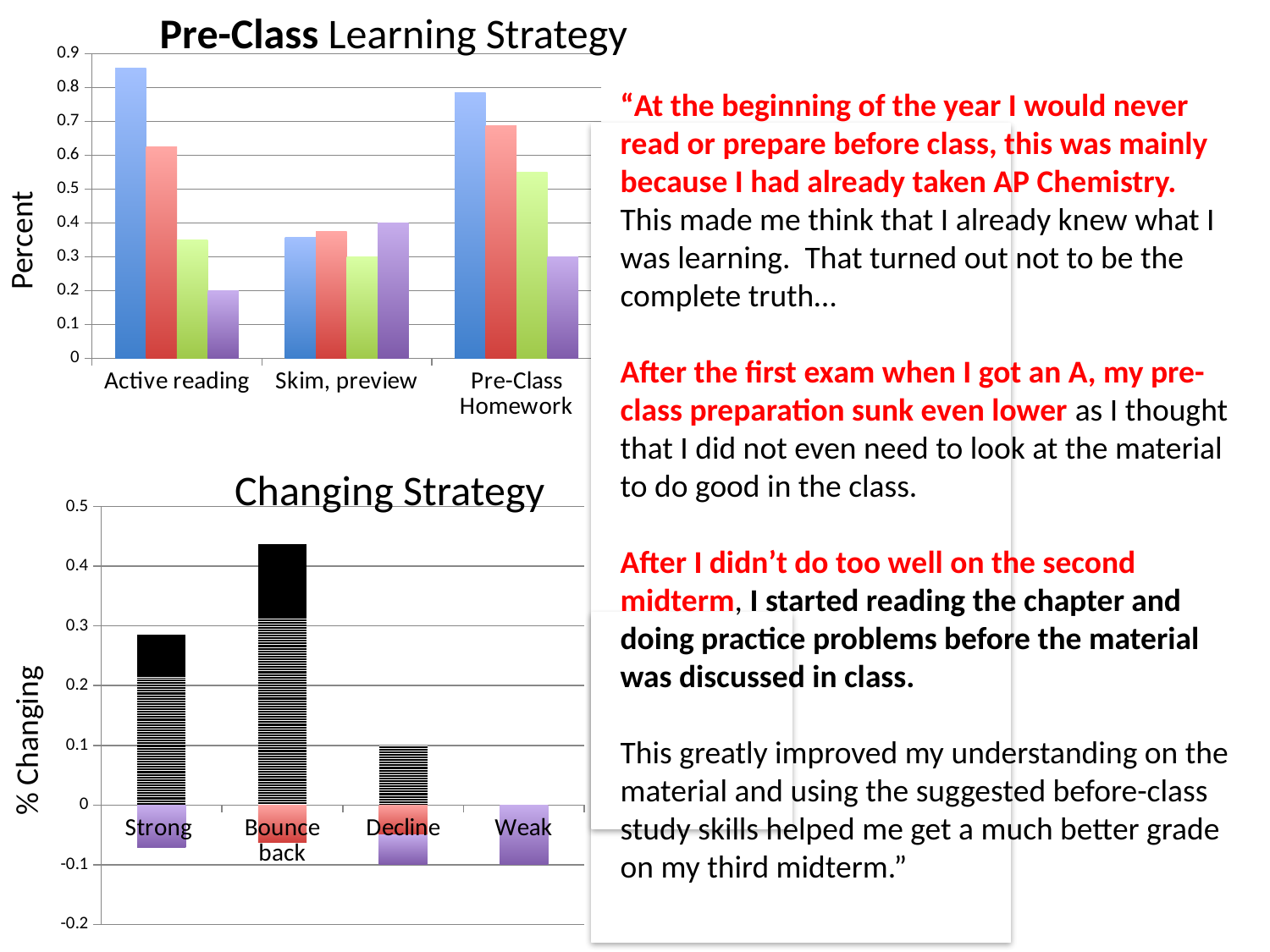
In the 'Pre-Class Learning Strategy' chart, is the blue bar for Active reading greater or less than 0.8? greater In the 'Pre-Class Learning Strategy' chart, is the green bar for Pre-Class Homework greater or less than 0.5? greater In the 'Changing Strategy' chart, which category has the tallest stacked bar above zero? Bounce back What is the y-axis label of the 'Pre-Class Learning Strategy' chart? Percent In the 'Changing Strategy' chart, is the top of the stacked bar for Bounce back greater or less than 0.4? greater In the 'Pre-Class Learning Strategy' chart, which category has the tallest blue bar? Active reading What is the y-axis label of the 'Changing Strategy' chart? % Changing How many categories are shown on the x axis of the 'Changing Strategy' chart? 4 In the 'Pre-Class Learning Strategy' chart, is the green bar larger for Active reading or for Pre-Class Homework? Pre-Class Homework What kind of chart is the 'Pre-Class Learning Strategy' chart? bar chart How many categories are shown on the x axis of the 'Pre-Class Learning Strategy' chart? 3